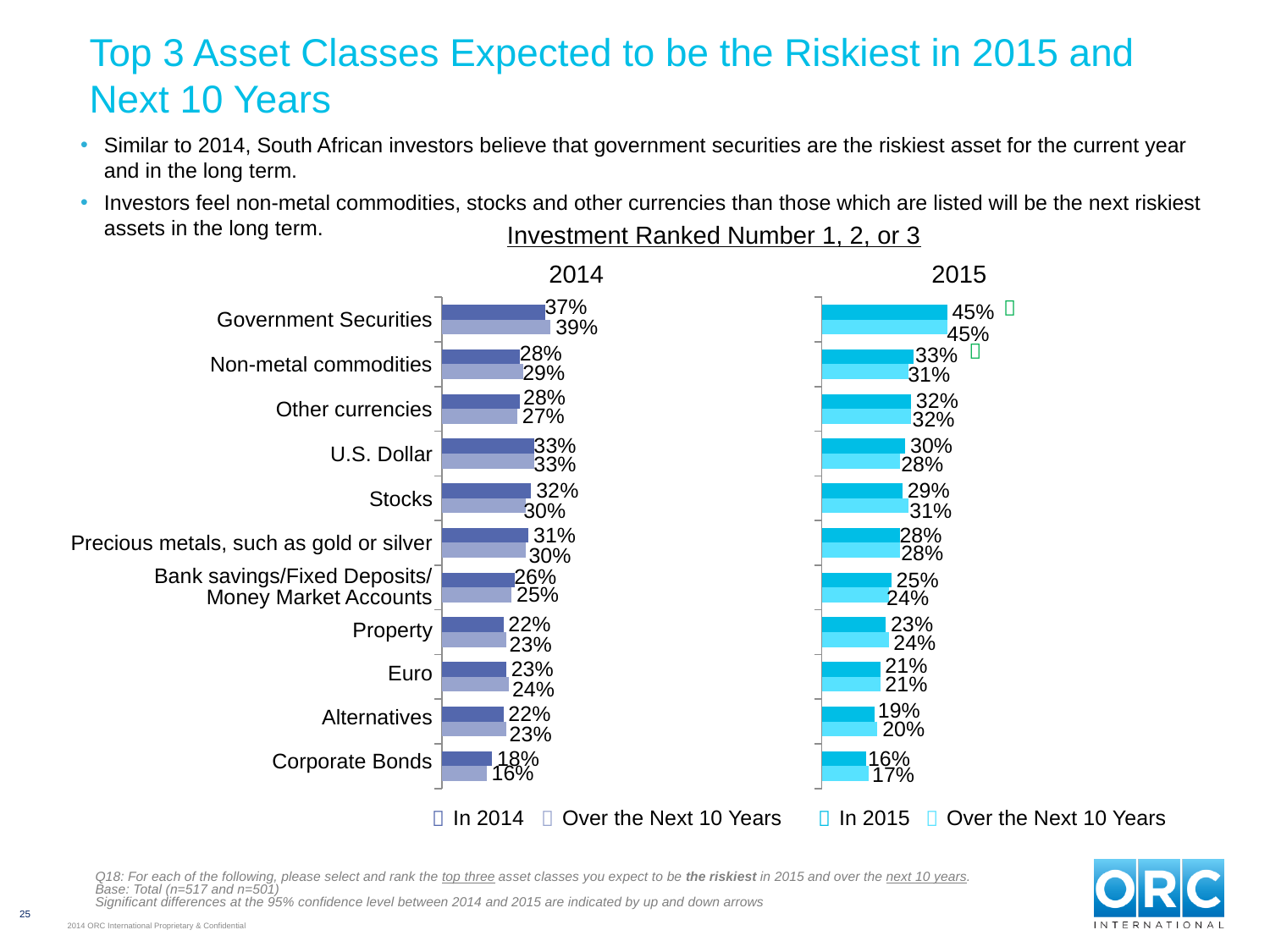
In the 2015 chart, what is the value for Corporate Bonds in the 'In 2015' series? 16% In the 2015 chart, what is the value for Non-metal commodities in the 'Over the Next 10 Years' series? 31% In the 2015 chart, which asset class has the highest value in the 'In 2015' series? Government Securities What type of chart is used to show the 2015 data? Bar chart In the 2014 chart, what is the value for U.S. Dollar in the 'Over the Next 10 Years' series? 33% How many series does the legend list for the 2015 chart? 2 In the 2014 chart, what is the value for Government Securities in the 'In 2014' series? 37% In the 2014 chart, which asset class has the lowest value in the 'Over the Next 10 Years' series? Corporate Bonds What is the title shown above the two charts? Investment Ranked Number 1, 2, or 3 In the 2015 chart, what is the difference between the 'In 2015' values for Government Securities and Non-metal commodities? 12 percentage points In the 2014 chart, which is larger for Stocks: the 'In 2014' value or the 'Over the Next 10 Years' value? In 2014 How many asset classes are listed in the 2014 chart? 11